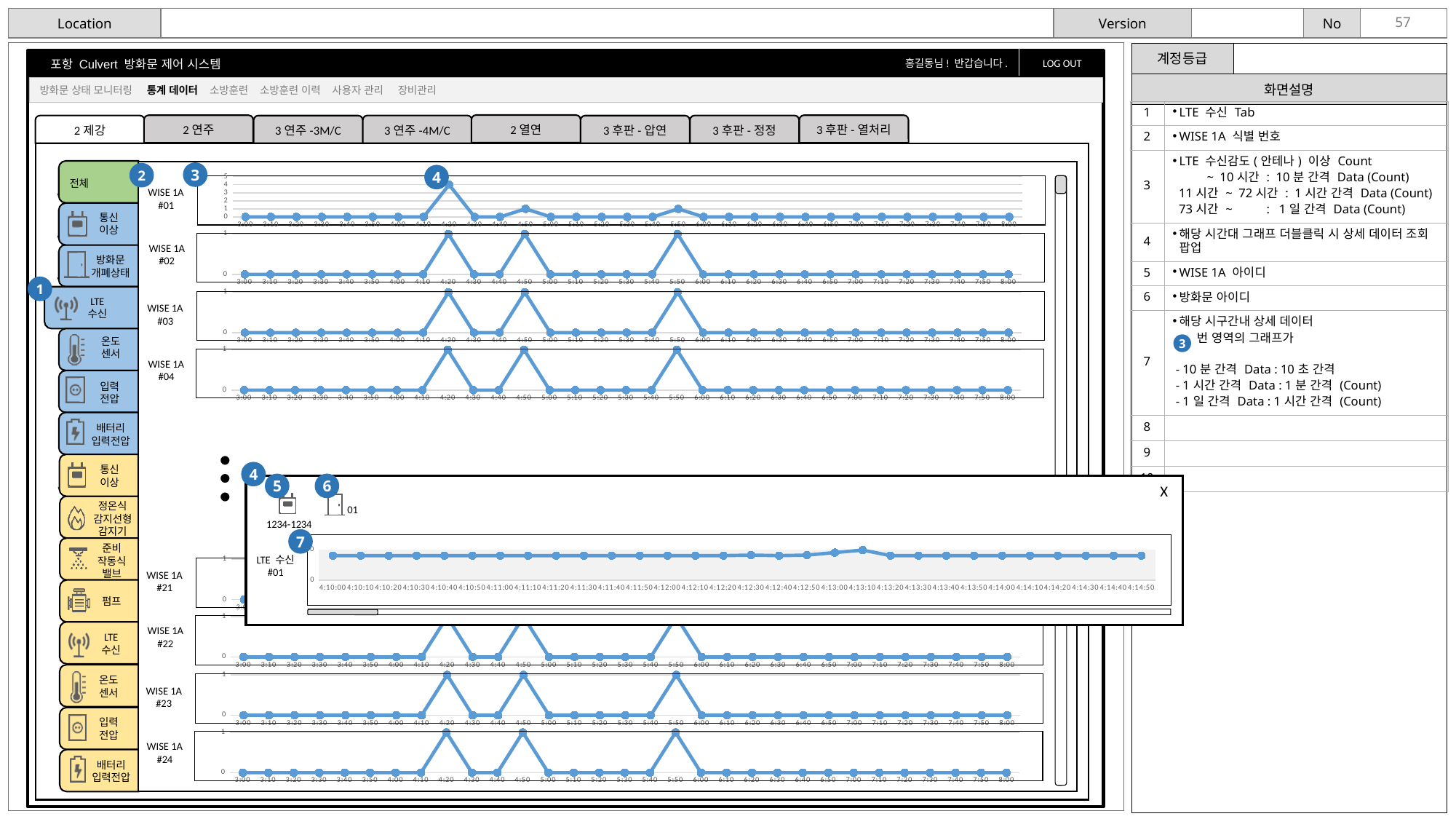
What kind of chart is used for the WISE 1A #02 panel? line chart In the popup chart, at which time is the value highest? 4:13:10 In the WISE 1A #23 chart, how many peaks rise above 0? 3 What is the label of the chart shown in the popup window? LTE 수신 #01 In the WISE 1A #01 chart, is the value at 4:20 greater or less than 3? greater In the WISE 1A #02 chart, what is the value at 4:20? 1 What is the first and last x-axis tick on the WISE 1A #24 chart? 3:00 and 8:00 How many WISE 1A chart panels are labeled in the main screen area? 8 In the WISE 1A #22 chart, is the value at 4:50 larger than the value at 5:00? Yes In the WISE 1A #01 chart, is the value at 6:00 greater or less than 1? less In the WISE 1A #03 chart, what is the value at 3:00? 0 In the WISE 1A #04 chart, at which times does the line reach 1? 4:20, 4:50, 5:50